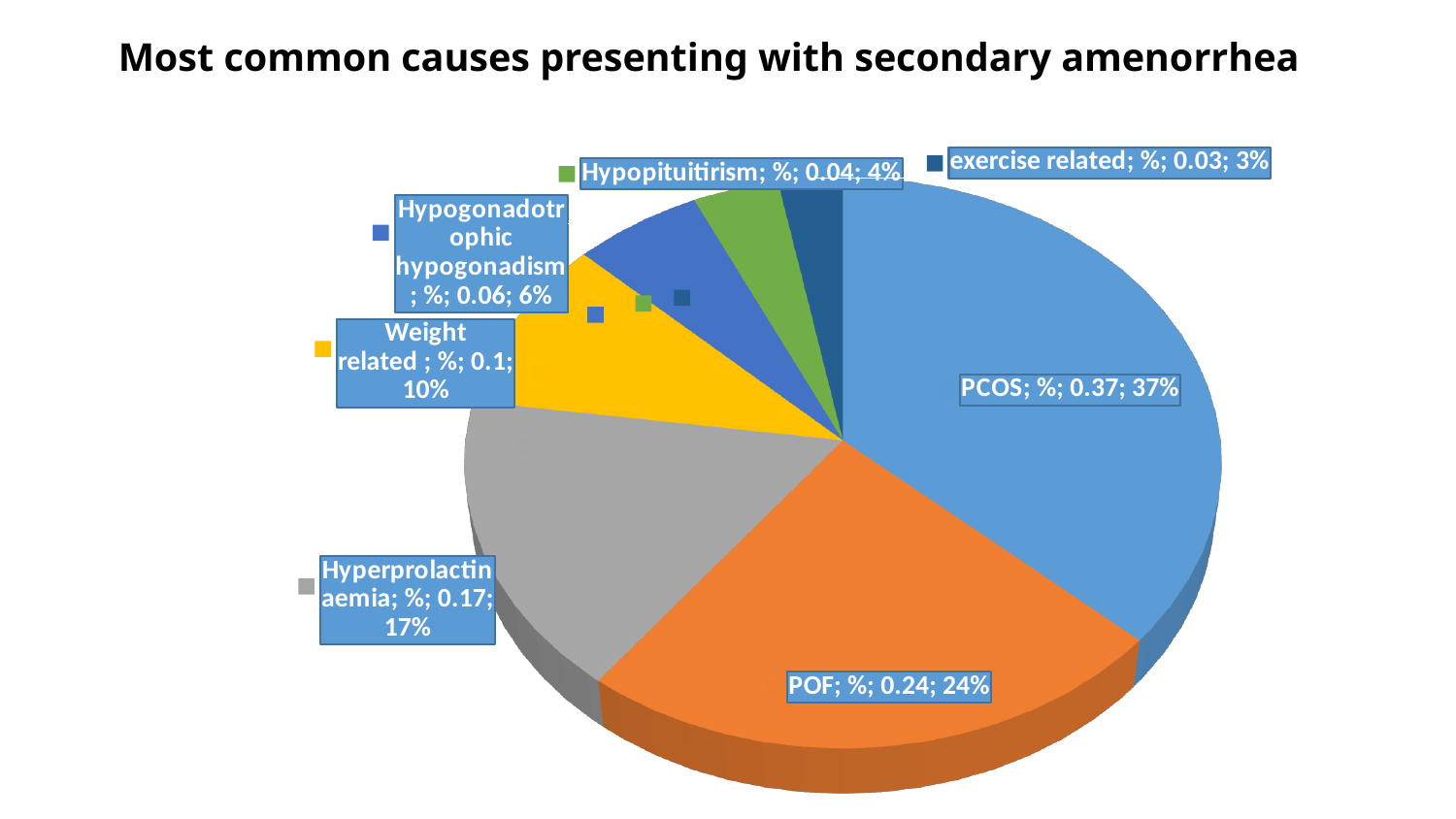
What percentage share does PCOS have in the pie chart? 37% What percentage share does Hyperprolactinaemia have in the pie chart? 17% What percentage share does Weight related have in the pie chart? 10% Which is larger, the share for Hypopituitirism or the share for Hypogonadotrophic hypogonadism? Hypogonadotrophic hypogonadism What percentage share does POF have in the pie chart? 24% Which cause has the smallest slice of the pie chart? exercise related What kind of chart is shown on the slide? pie chart Which cause has the largest slice of the pie chart? PCOS What percentage share does exercise related have in the pie chart? 3% What is the title of the chart? Most common causes presenting with secondary amenorrhea What is the difference in percentage points between PCOS and POF? 13 How many slices does the pie chart have? 7